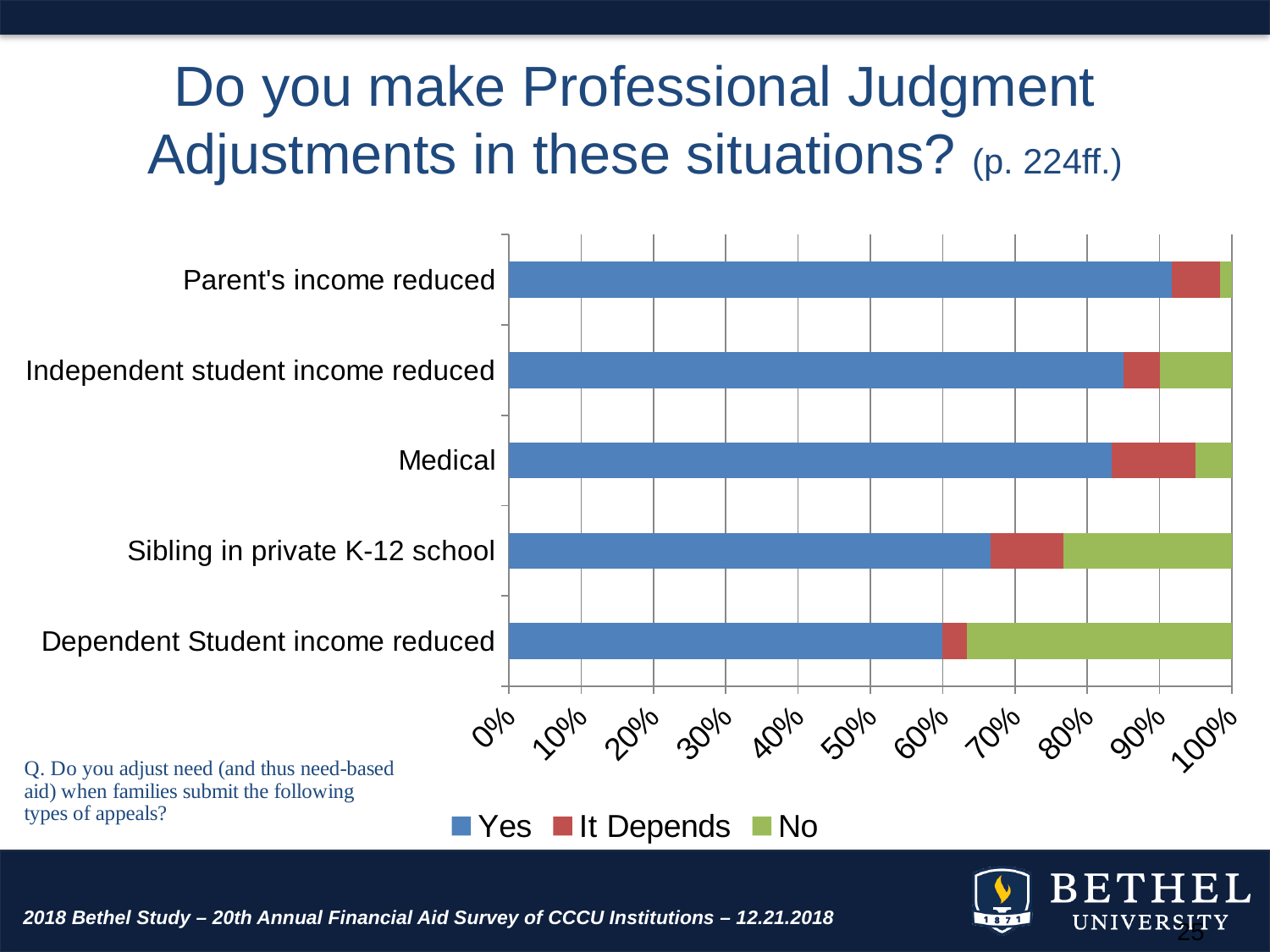
Which category has the largest 'Yes' share? Parent's income reduced How many series does the legend list? 3 Is the 'Yes' value for Dependent Student income reduced greater or less than 70%? less Is the 'Yes' value for Sibling in private K-12 school greater or less than 60%? greater How many categories (situations) are plotted on the chart? 5 Which category has the largest 'No' share? Dependent Student income reduced What kind of chart is shown on the slide? stacked bar chart Is the 'Yes' value for Parent's income reduced greater or less than 90%? greater Which has a larger 'Yes' share: Medical or Sibling in private K-12 school? Medical What are the three legend entries of the chart? Yes, It Depends, No Which category has the smallest 'Yes' share? Dependent Student income reduced Which has a larger 'No' share: Sibling in private K-12 school or Parent's income reduced? Sibling in private K-12 school